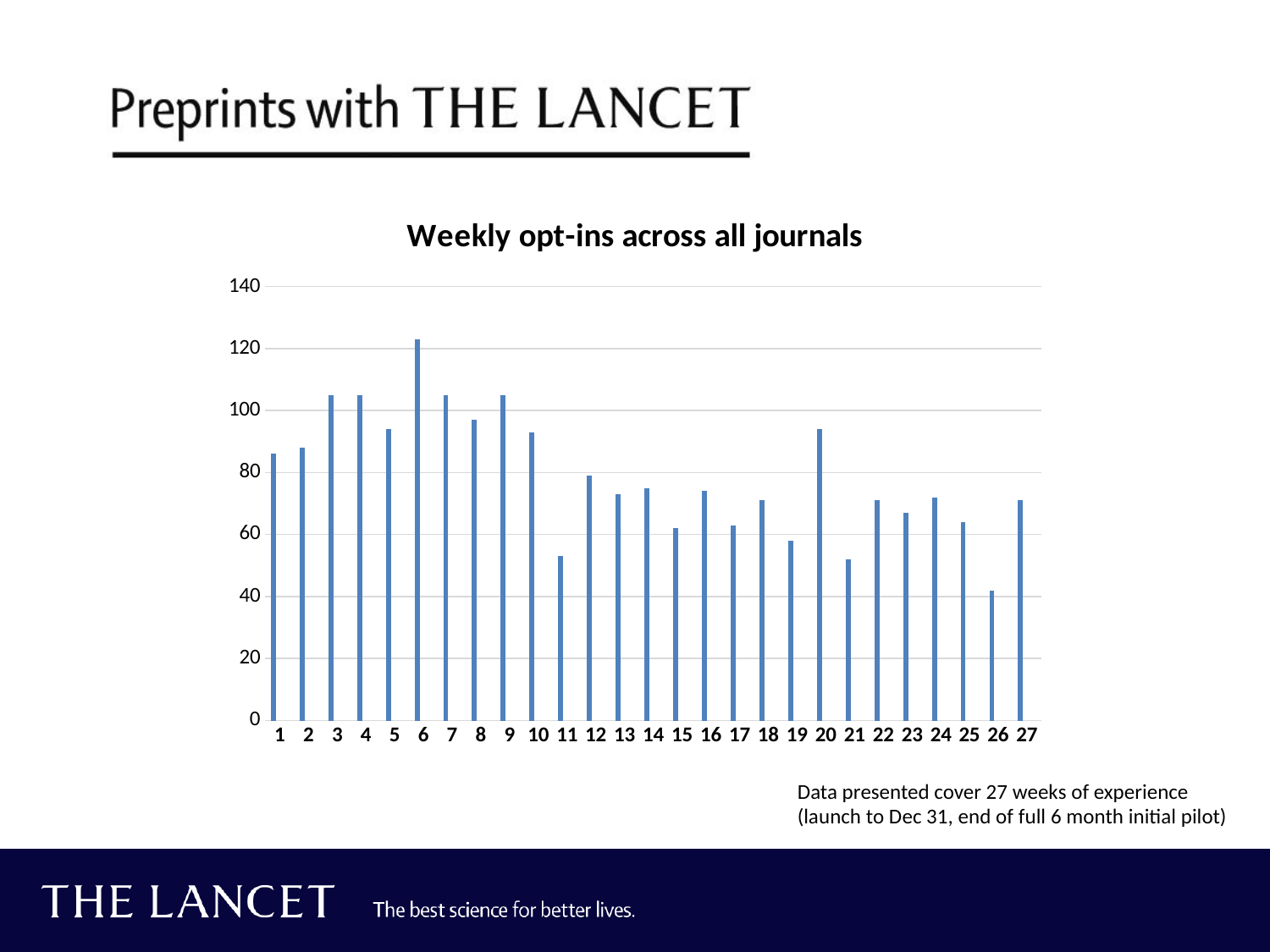
Is the value for week 13 greater or less than 80? less Is the value for week 20 greater or less than 80? greater Which is larger, the value for week 3 or the value for week 11? week 3 What is the title of the chart? Weekly opt-ins across all journals Is the value for week 6 greater or less than 100? greater Which week has the highest number of opt-ins? 6 Which week has the lowest number of opt-ins? 26 How many weeks are plotted on the x axis of the chart? 27 Do the weekly opt-ins generally rise or fall from week 1 to week 27? fall What kind of chart is shown on the slide? bar chart